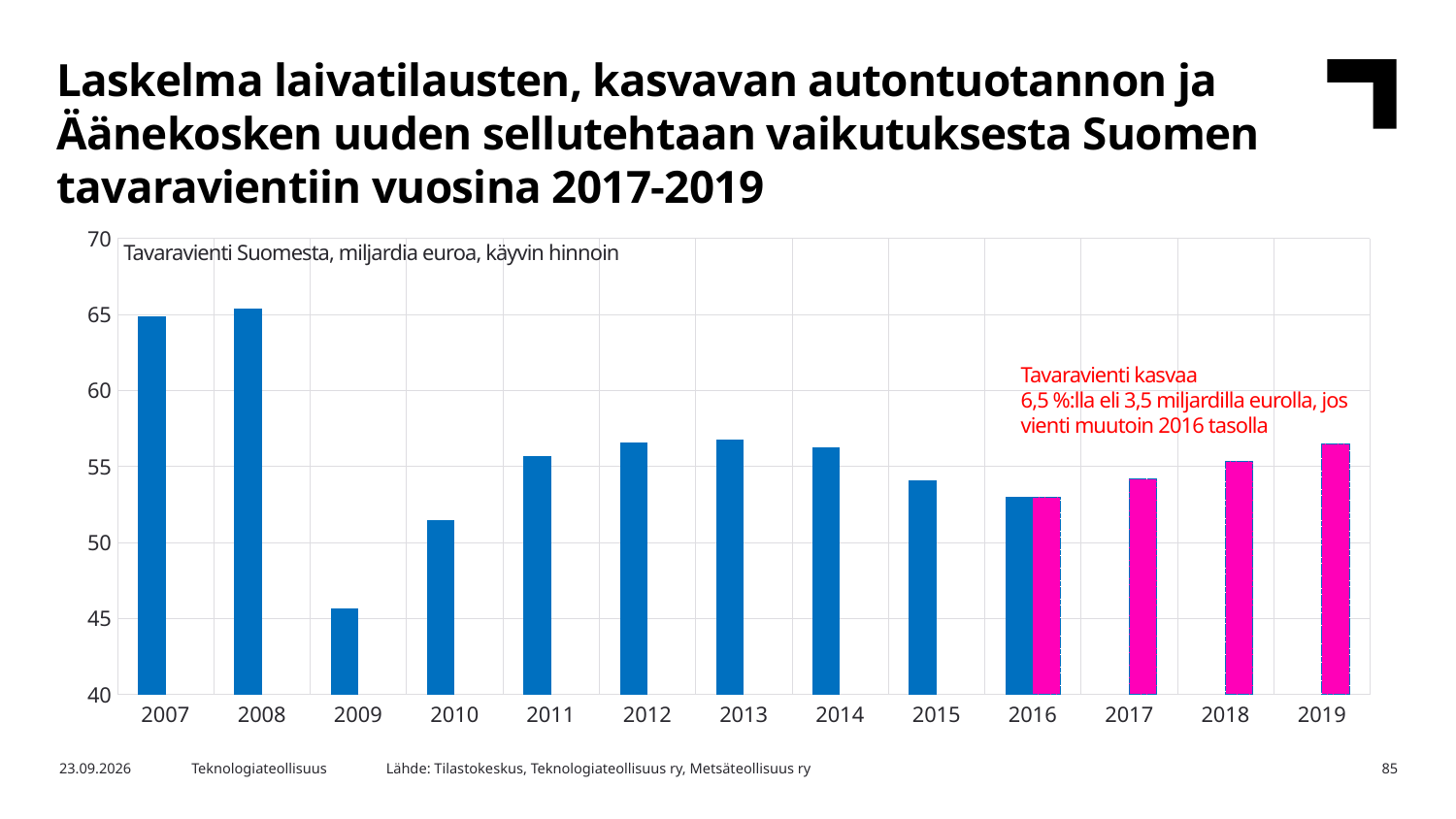
What kind of chart is shown on the slide? Bar chart Which is larger, the value for 2009 or the value for 2010? 2010 Which is larger, the value for 2017 or the value for 2019? 2019 Is the value for 2013 greater or less than 55? greater Is the value for 2010 greater or less than 50? greater Is the value for 2009 greater or less than 50? less Which year has the highest value in the chart? 2008 Do the values rise or fall from 2016 to 2019? rise Which year has the lowest value in the chart? 2009 What is the label printed inside the top of the chart area? Tavaravienti Suomesta, miljardia euroa, käyvin hinnoin How many years are shown on the x axis of the chart? 13